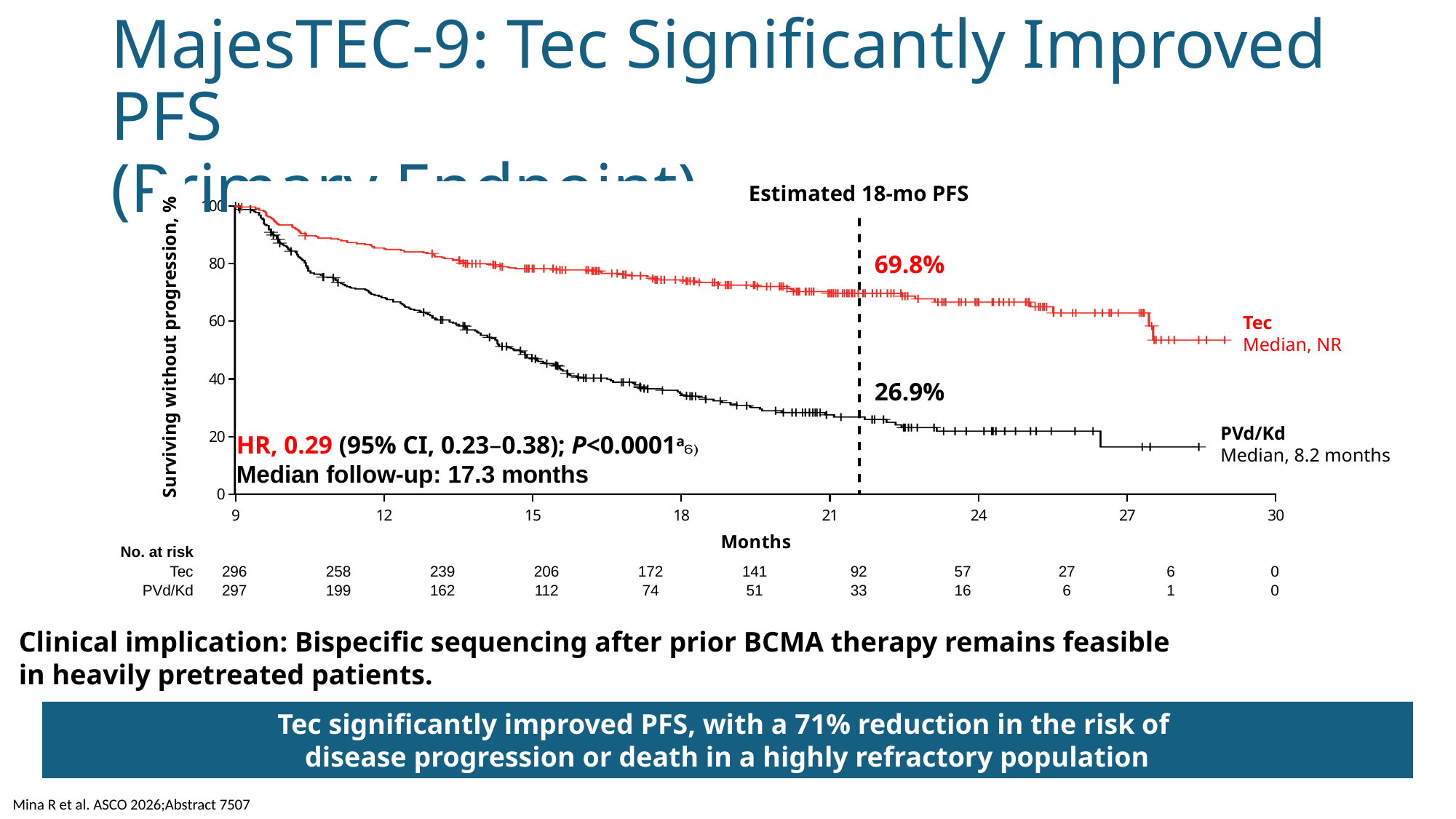
What kind of chart is shown on the slide? Kaplan-Meier survival curve Which arm has the higher estimated 18-month PFS, Tec or PVd/Kd? Tec What is the estimated 18-month PFS for the PVd/Kd arm? 26.9% How many patients were at risk in the Tec arm at the first time point in the No. at risk table? 296 How many treatment arms are plotted on the chart? 2 What is the median follow-up shown on the chart? 17.3 months What is the median PFS for the PVd/Kd arm? 8.2 months What colour is the Tec curve? Red What is the estimated 18-month PFS for the Tec arm? 69.8% What is the difference in estimated 18-month PFS between the Tec and PVd/Kd arms? 42.9 percentage points What is the median PFS for the Tec arm? NR What hazard ratio is shown on the chart? 0.29